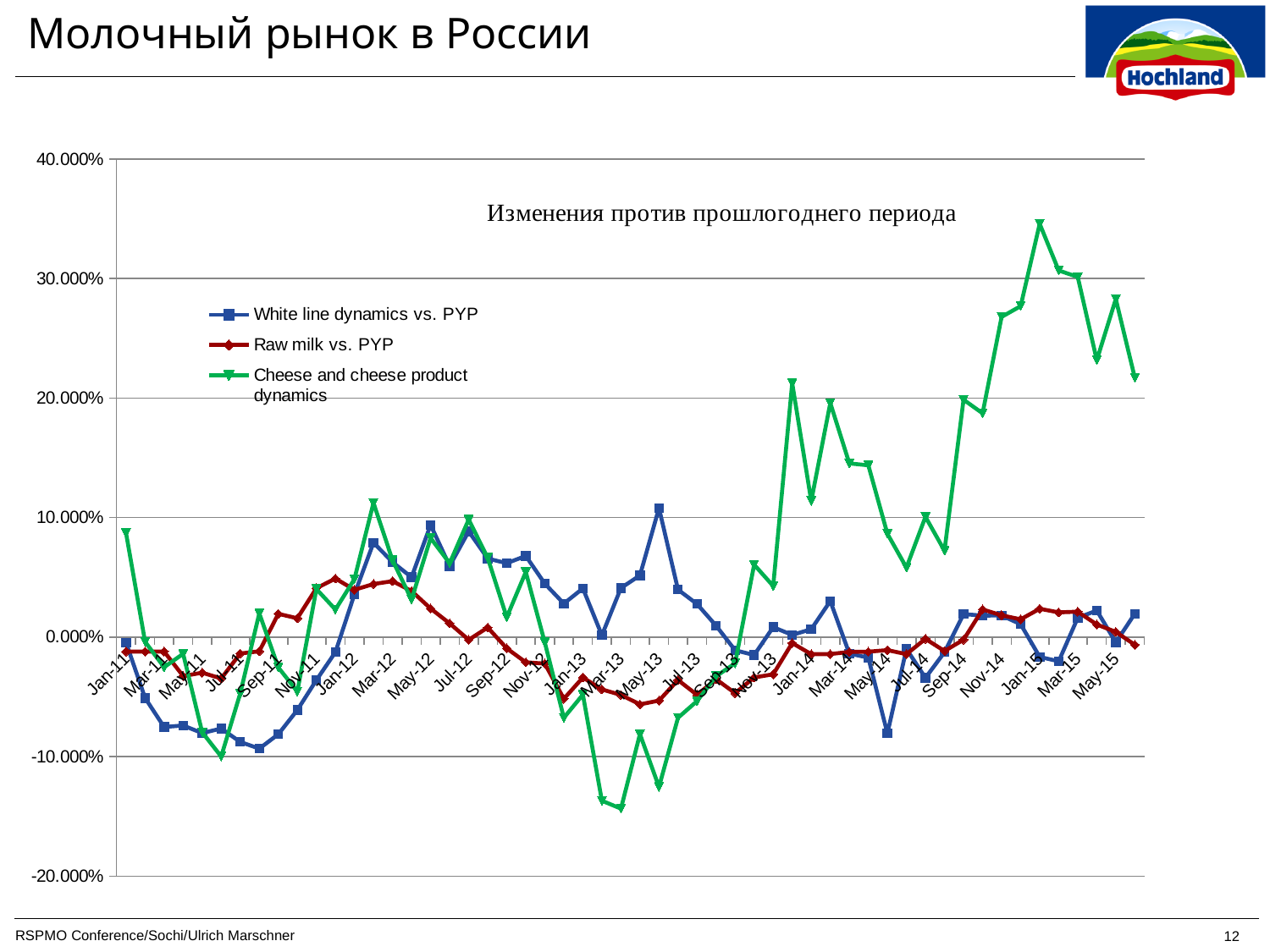
Is the value of Cheese and cheese product dynamics at Mar-13 greater or less than -10.000%? less Which series reaches the highest value anywhere on the chart? Cheese and cheese product dynamics Is the value of Cheese and cheese product dynamics at Jan-15 greater or less than 30.000%? greater What kind of chart is shown on the slide? line chart At Jan-15, which series has the larger value: White line dynamics vs. PYP or Cheese and cheese product dynamics? Cheese and cheese product dynamics Which series reaches the lowest value anywhere on the chart? Cheese and cheese product dynamics Is the value of Raw milk vs. PYP at Mar-12 greater or less than 10.000%? less How many series does the legend list? 3 What text is written inside the plot area as the chart's title? Изменения против прошлогоднего периода What colour is the line for Cheese and cheese product dynamics? green Does the Cheese and cheese product dynamics series rise or fall between Jul-14 and Jan-15? rise